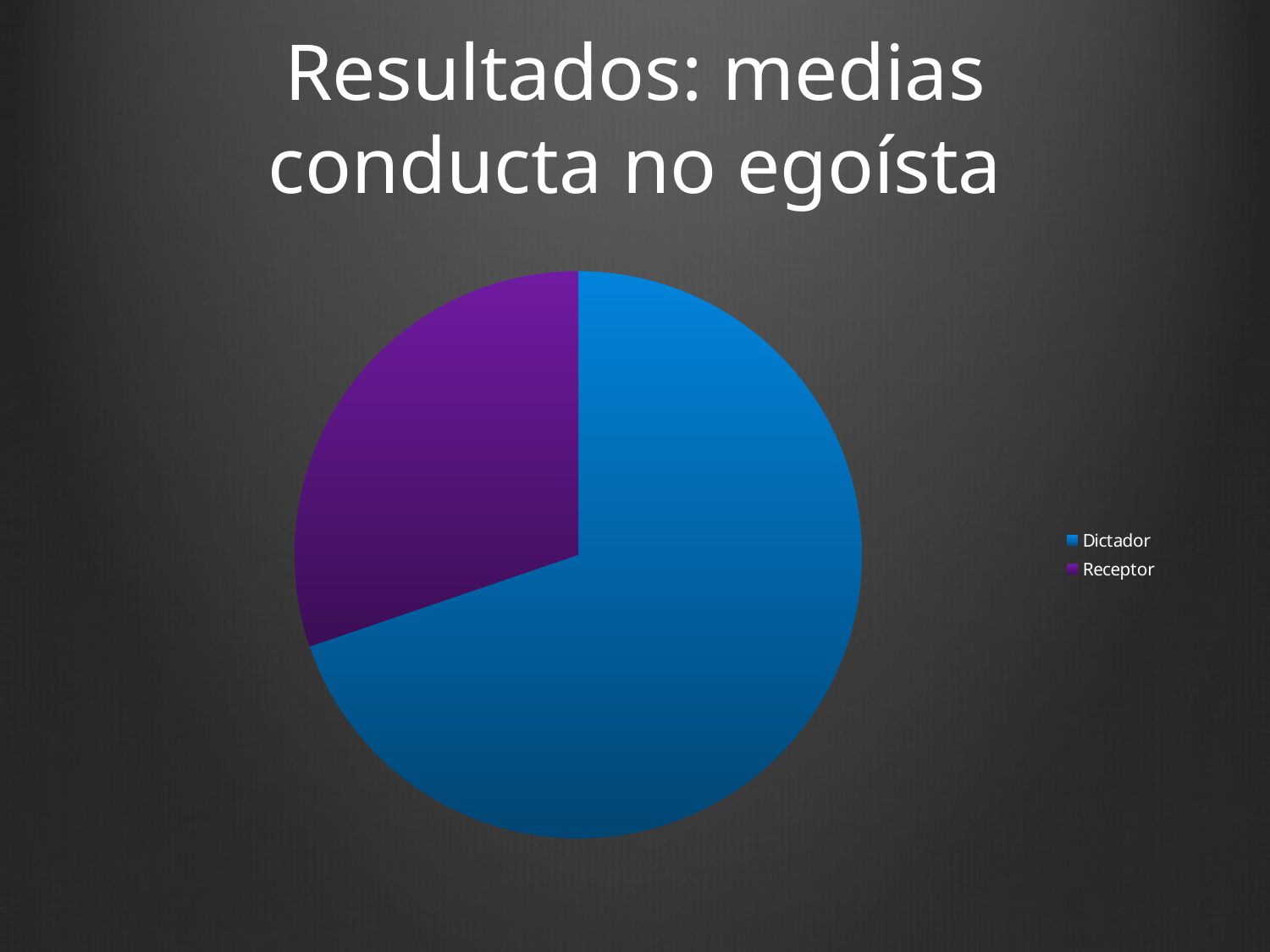
What colour is the Receptor slice? purple Which is larger, the Dictador slice or the Receptor slice? Dictador Which slice is the largest in the pie chart? Dictador What kind of chart is shown on the slide? pie chart How many slices does the pie chart have? 2 Which slice is the smallest in the pie chart? Receptor What colour is the Dictador slice? blue How many entries does the legend list? 2